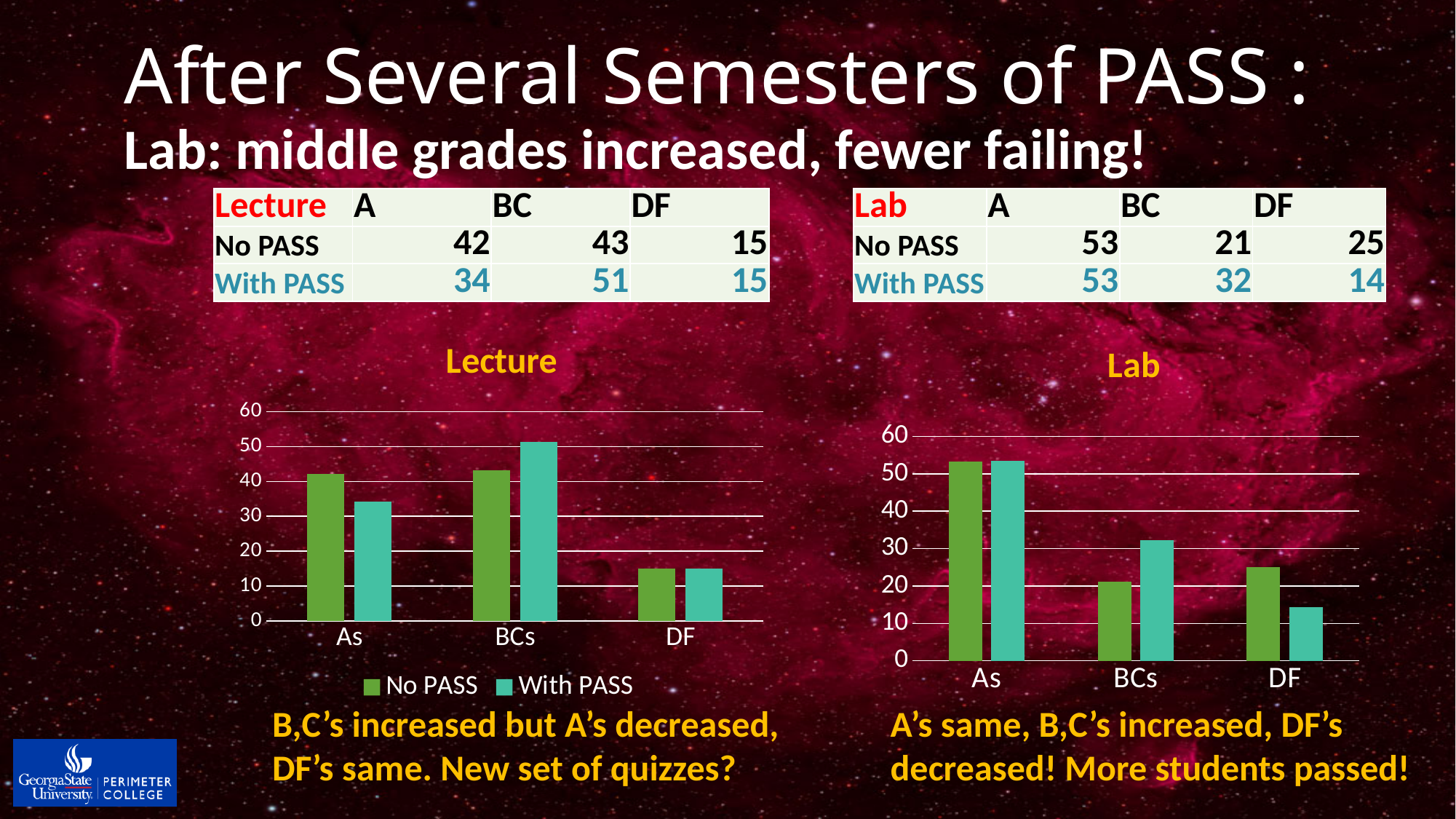
In the Lecture chart, what is the With PASS value for As? 34 How many categories are shown on the x axis of the Lecture chart? 3 In the Lab chart, what is the No PASS value for DF? 25 In the Lecture chart, which is larger for As: the No PASS value or the With PASS value? No PASS In the Lab chart, what is the difference between the No PASS and With PASS values for DF? 11 In the Lecture chart, what is the No PASS value for BCs? 43 How many series does the legend of the Lecture chart list? 2 In the Lab chart, is the No PASS value for As greater or less than 50? greater In the Lab chart, which category has the lowest With PASS value? DF What type of chart is the Lab chart? Bar chart In the Lecture chart, which category has the highest With PASS value? BCs In the Lab chart, what is the With PASS value for BCs? 32